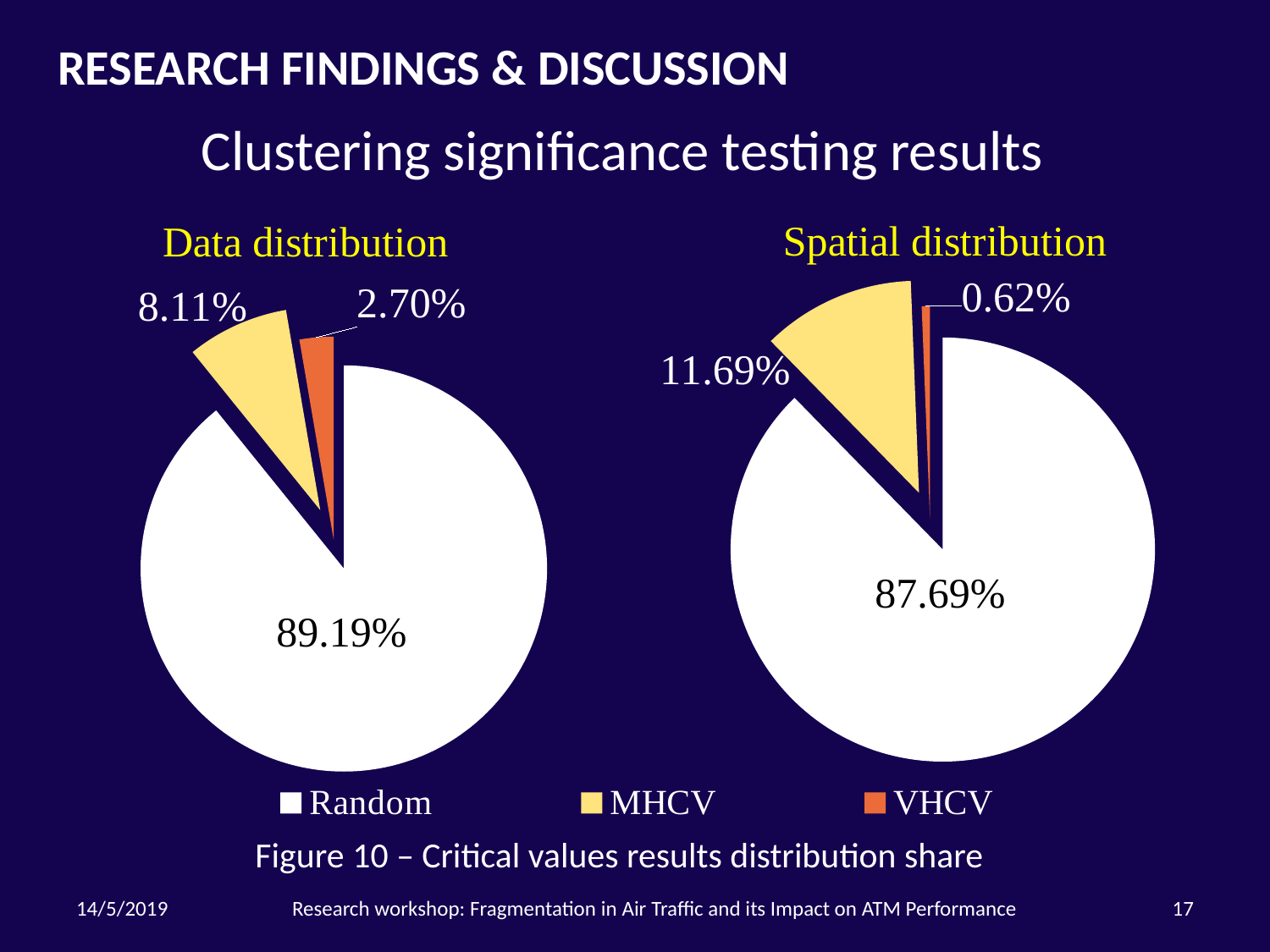
How many categories does each pie chart show? 3 In the Data distribution pie chart, what is the difference between the MHCV and VHCV shares? 5.41% In the Spatial distribution pie chart, what share does VHCV have? 0.62% What is the figure caption below the charts? Figure 10 – Critical values results distribution share Which is larger: the MHCV share in the Data distribution chart or the MHCV share in the Spatial distribution chart? Spatial distribution In the Spatial distribution pie chart, what share does MHCV have? 11.69% In the Data distribution pie chart, which category has the largest share? Random In the Data distribution pie chart, what share does VHCV have? 2.70% What type of chart is used for the Data distribution and Spatial distribution? Pie chart In the Data distribution pie chart, what share does Random have? 89.19% How many entries does the legend list? 3 In the Spatial distribution pie chart, which category has the smallest share? VHCV